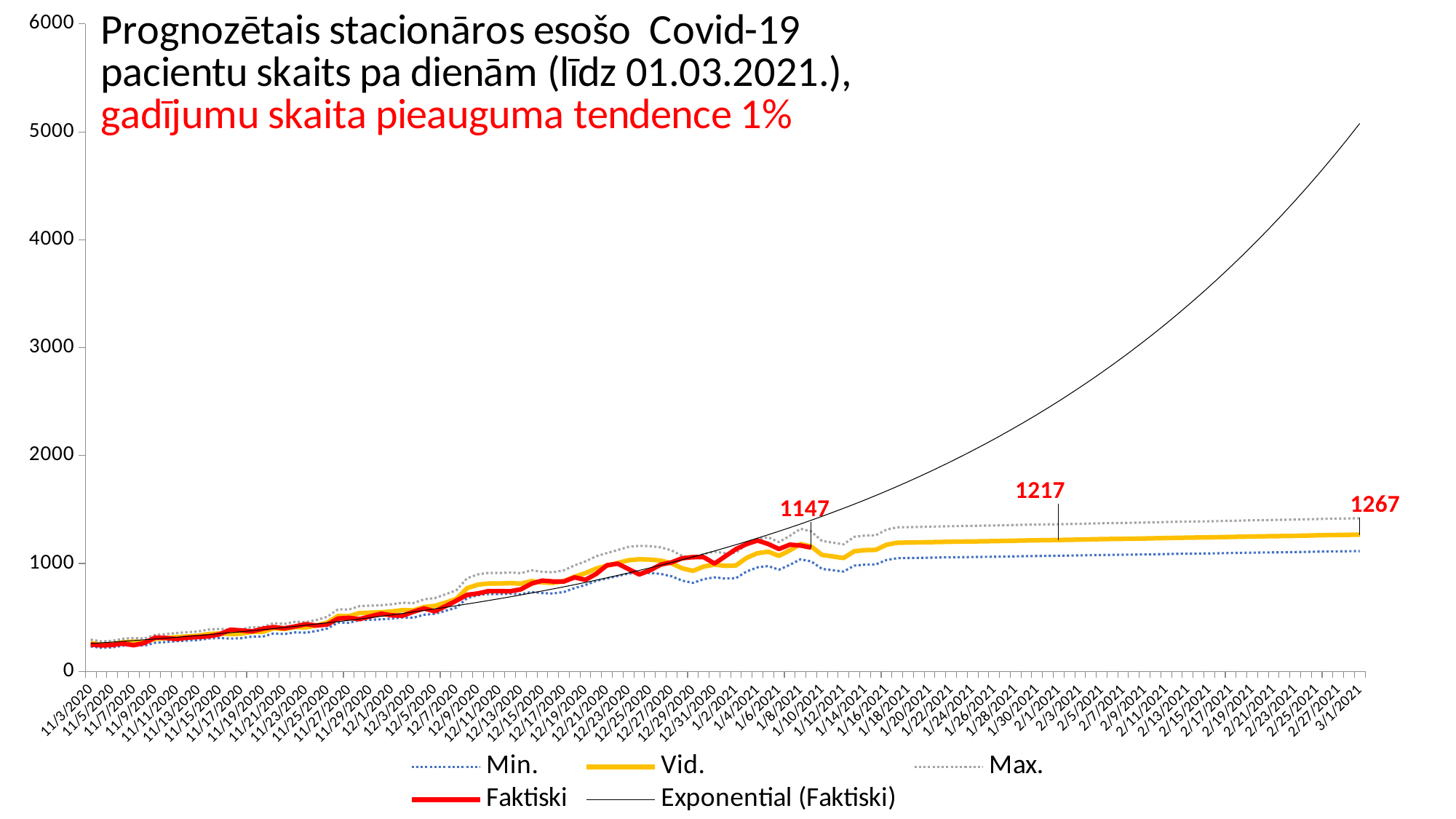
Which labelled value is larger, the one at 3/1/2021 or the one at 2/1/2021? 3/1/2021 (1267) Which series is highest at 3/1/2021? Exponential (Faktiski) What value is labelled on the Vid. line at 3/1/2021? 1267 What value is labelled on the Vid. line at 2/1/2021? 1217 Is the value of the Exponential (Faktiski) line at 3/1/2021 greater or less than 4000? greater What value is labelled on the chart around 1/10/2021? 1147 What kind of chart is shown on the slide? line chart Is the value of the Max. line at 3/1/2021 greater or less than 2000? less What is the difference between the labelled values 1267 (3/1/2021) and 1217 (2/1/2021)? 50 Which series is lowest at 3/1/2021? Min. How many series does the legend list? 5 What is the difference between the labelled values 1217 (2/1/2021) and 1147 (1/10/2021)? 70